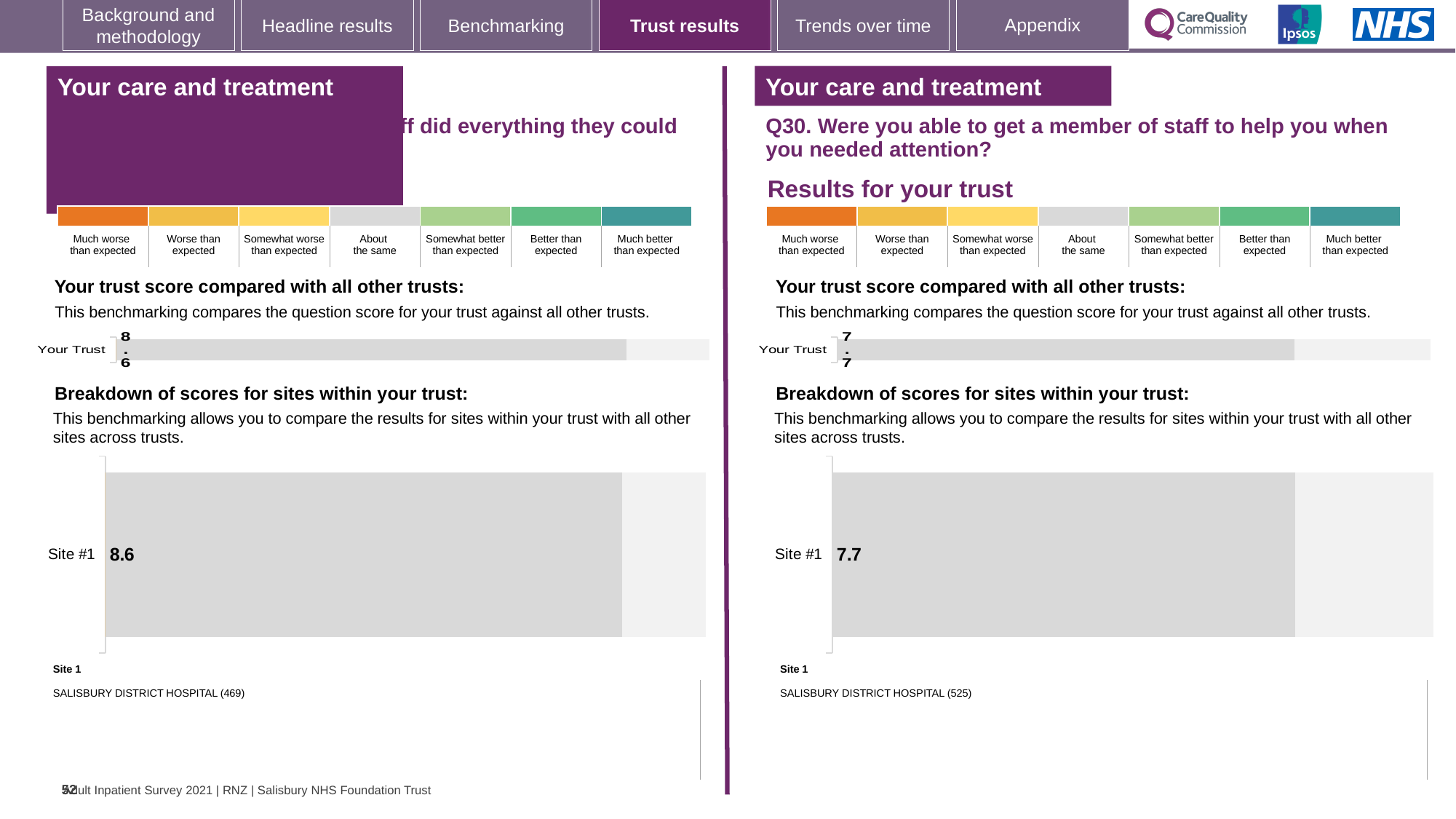
On the right half of the slide (Q30), what is the score shown for Your Trust in the 'Your trust score compared with all other trusts' chart? 7.7 What type of chart is used to show the Your Trust score on the left half of the slide? Bar chart In the left 'Breakdown of scores for sites within your trust' chart, what is the value for Site #1? 8.6 What type of chart is used to show the Site #1 score in the right breakdown chart (Q30)? Bar chart Which site name is listed under Site 1 for the right chart (Q30)? SALISBURY DISTRICT HOSPITAL (525) On the left half of the slide, what is the score shown for Your Trust in the 'Your trust score compared with all other trusts' chart? 8.6 In the right 'Breakdown of scores for sites within your trust' chart (Q30), what is the value for Site #1? 7.7 How many sites are shown in the left 'Breakdown of scores for sites within your trust' chart? 1 Which site name is listed under Site 1 for the left chart? SALISBURY DISTRICT HOSPITAL (469) What is the difference between the Site #1 score in the left breakdown chart and the Site #1 score in the right breakdown chart (Q30)? 0.9 Which is larger: the Site #1 score in the left breakdown chart or the Site #1 score in the right breakdown chart (Q30)? The left chart (8.6) How many sites are shown in the right 'Breakdown of scores for sites within your trust' chart (Q30)? 1